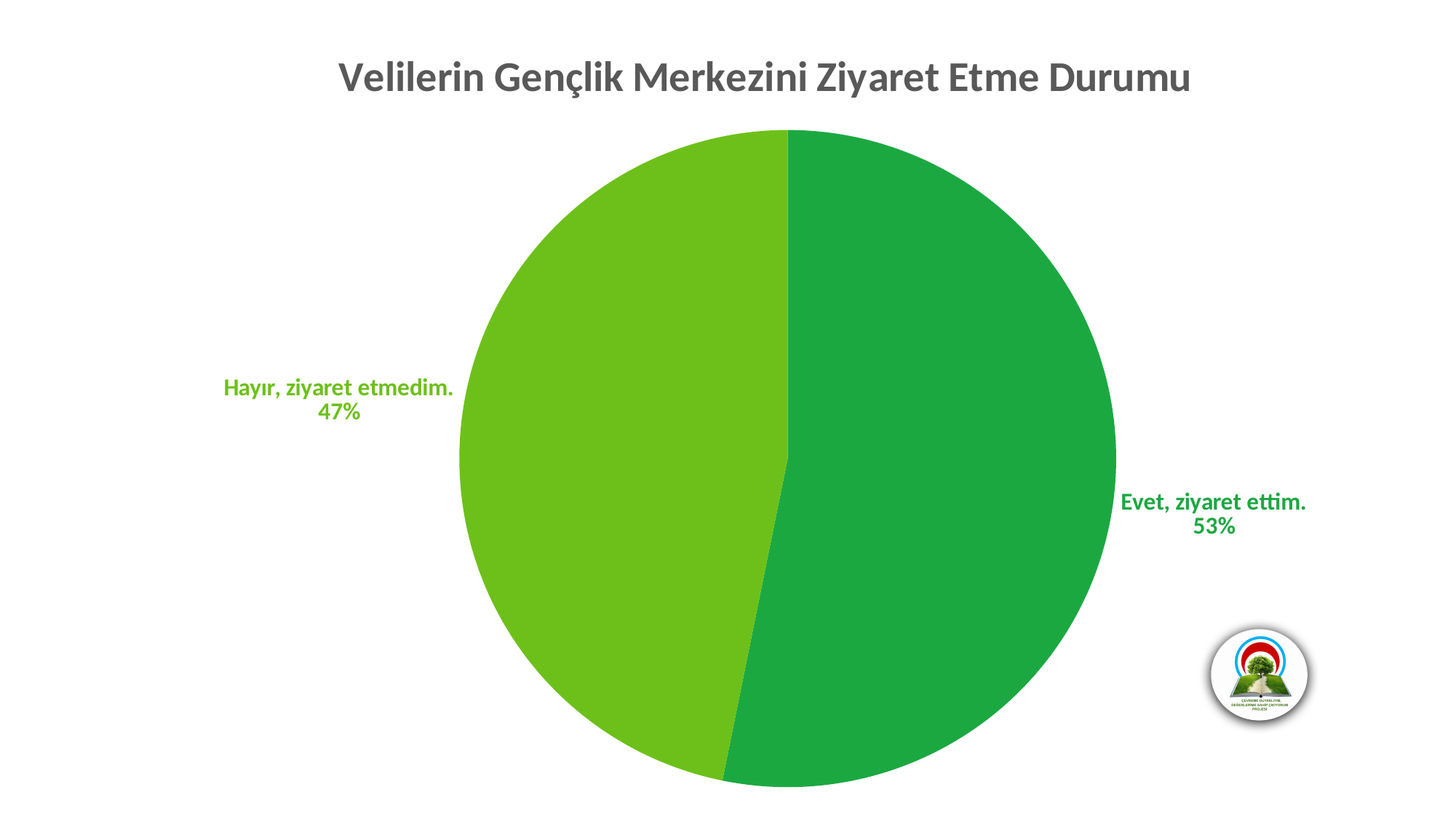
How many slices does the pie chart have? 2 Which slice is shown in the darker green colour? Evet, ziyaret ettim. Which is larger: the "Evet, ziyaret ettim." slice or the "Hayır, ziyaret etmedim." slice? Evet, ziyaret ettim. What is the difference in percentage points between the "Evet, ziyaret ettim." slice and the "Hayır, ziyaret etmedim." slice? 6 What share of the pie is labelled "Evet, ziyaret ettim."? 53% What kind of chart is shown on the slide? Pie chart Which slice is the smallest? Hayır, ziyaret etmedim. Which slice is the largest? Evet, ziyaret ettim. What is the title of the chart? Velilerin Gençlik Merkezini Ziyaret Etme Durumu What share of the pie is labelled "Hayır, ziyaret etmedim."? 47%